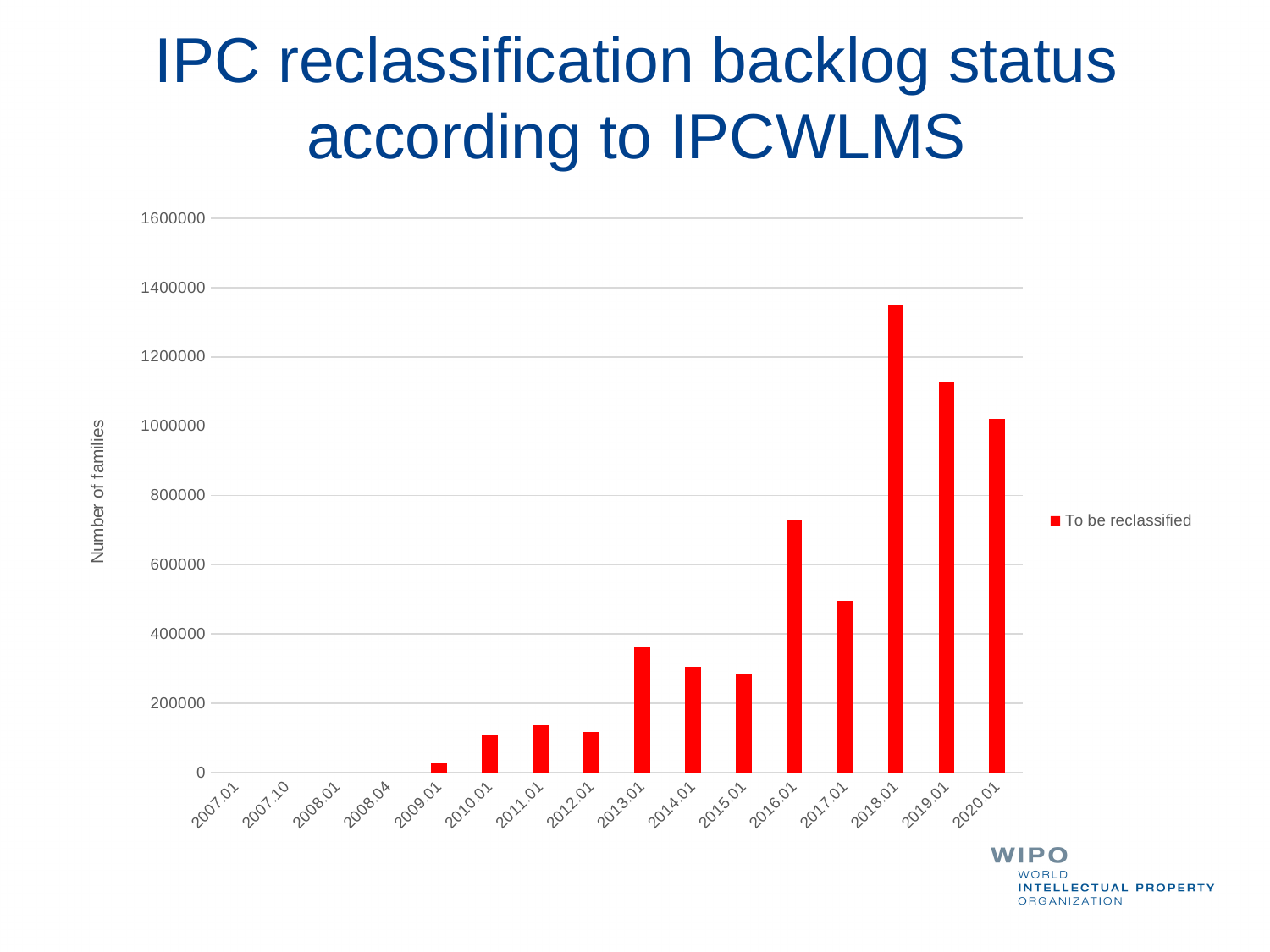
How many series does the legend list? 1 Is the value for 2013.01 greater or less than 400000? less Which is larger, the value for 2018.01 or the value for 2019.01? 2018.01 From 2018.01 to 2020.01, do the values rise or fall? fall What is the name of the series shown in the legend? To be reclassified Is the value for 2018.01 greater or less than 1200000? greater What is the label of the vertical axis? Number of families Is the value for 2016.01 greater or less than 600000? greater How many categories are shown on the x axis? 16 What kind of chart is shown on the slide? bar chart Which category has the highest value? 2018.01